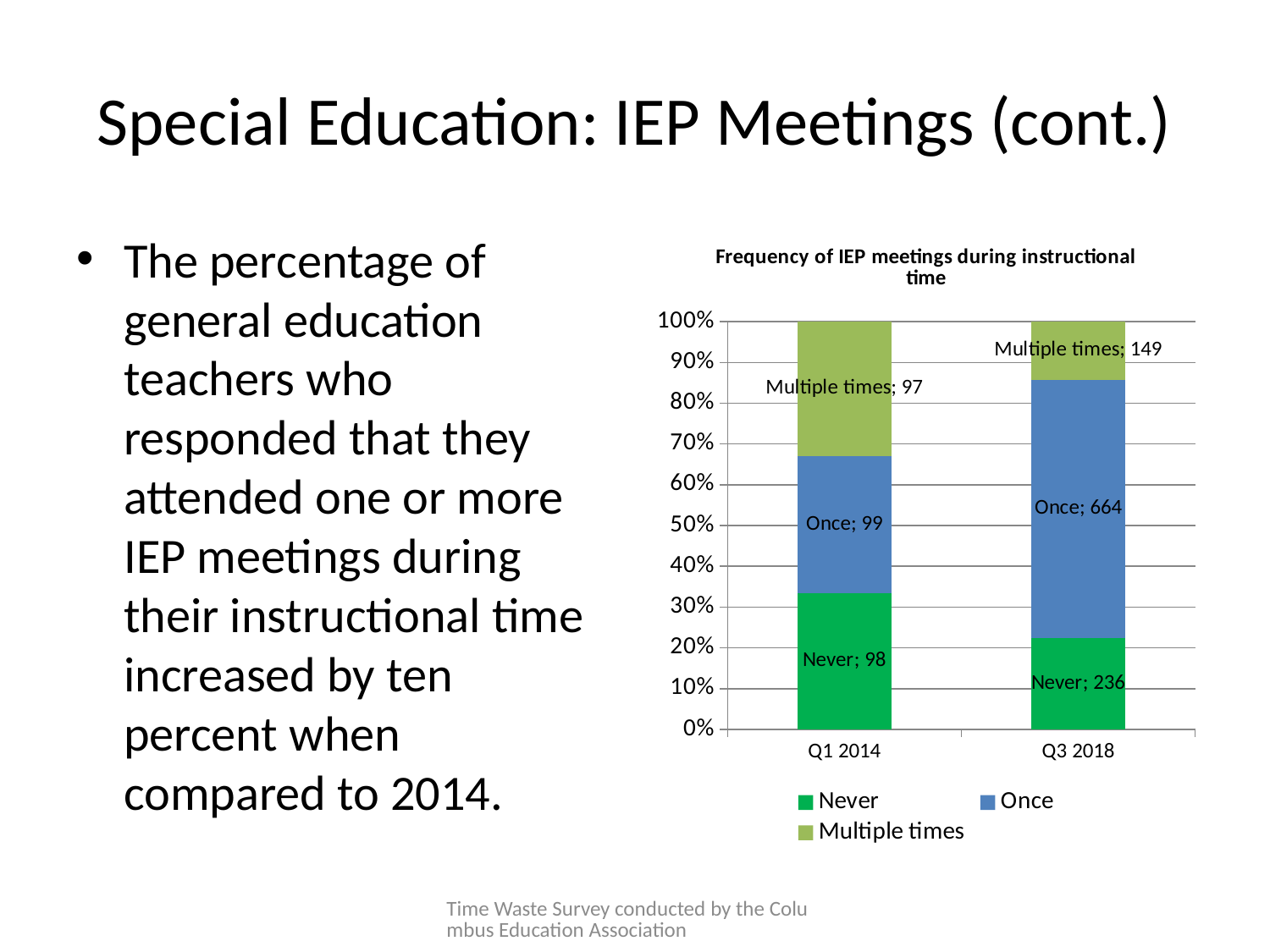
What is the value for Multiple times in Q3 2018? 149 How many series does the chart legend list? 3 What is the difference between the Never values for Q3 2018 and Q1 2014? 138 What is the value for Never in Q1 2014? 98 What is the total of the three values in the Q1 2014 bar? 294 Which series has the highest value in Q3 2018? Once What is the title of the chart? Frequency of IEP meetings during instructional time How many categories are shown on the x axis of the chart? 2 What type of chart is shown on the slide? stacked bar chart What is the total of the three values in the Q3 2018 bar? 1049 Which is larger, the Multiple times value for Q1 2014 or for Q3 2018? Q3 2018 What is the value for Once in Q3 2018? 664